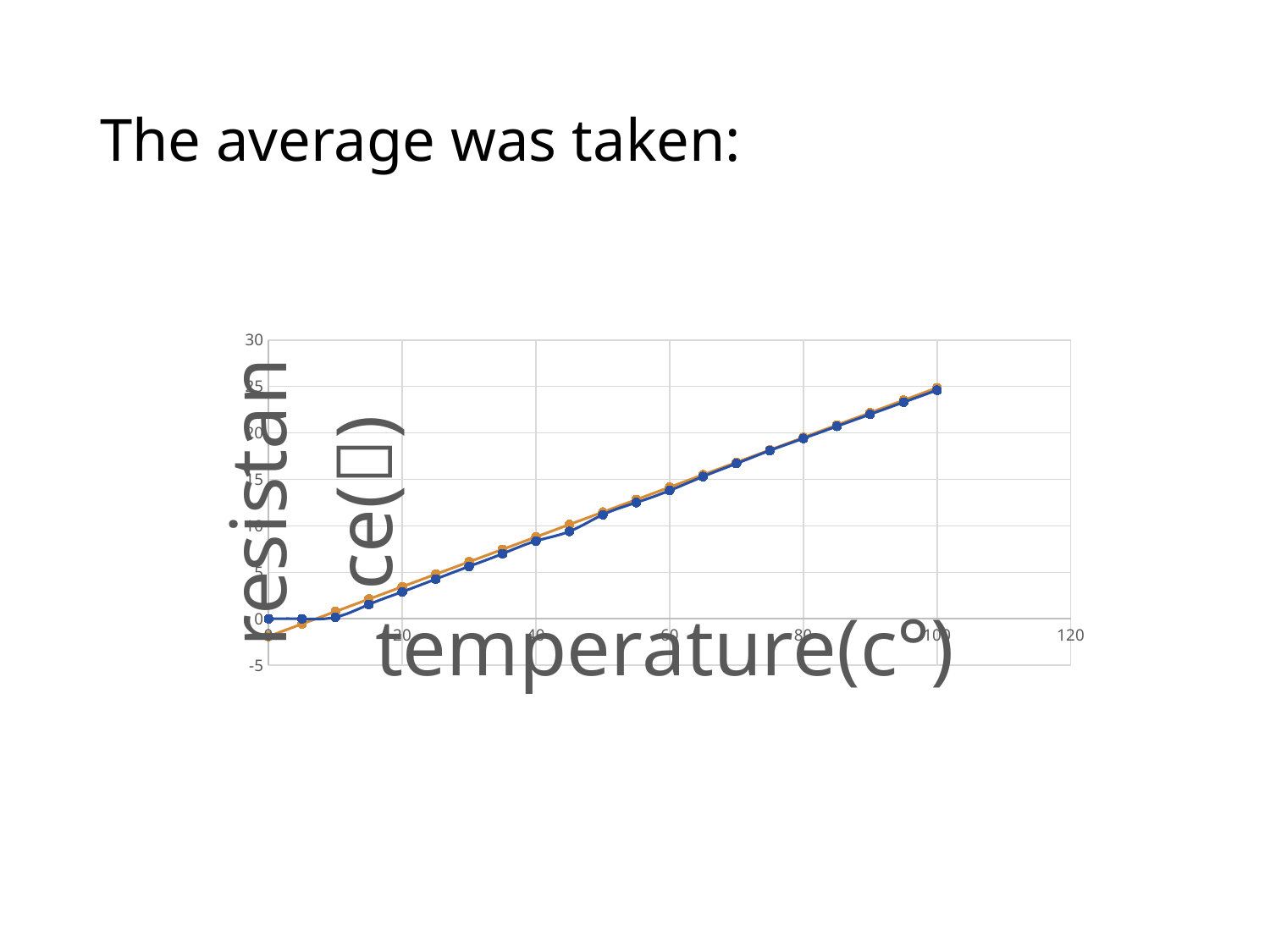
Do the plotted values rise or fall as temperature increases along the x axis? rise What is the label of the x axis? temperature(c°) How many lines (series) are plotted on the chart? 2 Is the value at a temperature of 40 greater or less than 10? less Is the value at a temperature of 100 greater or less than 20? greater What kind of chart is shown on the slide? line chart Is the value at a temperature of 80 greater or less than 15? greater What is the highest tick value shown on the x axis? 120 At which temperature does the plotted line reach its highest value? 100